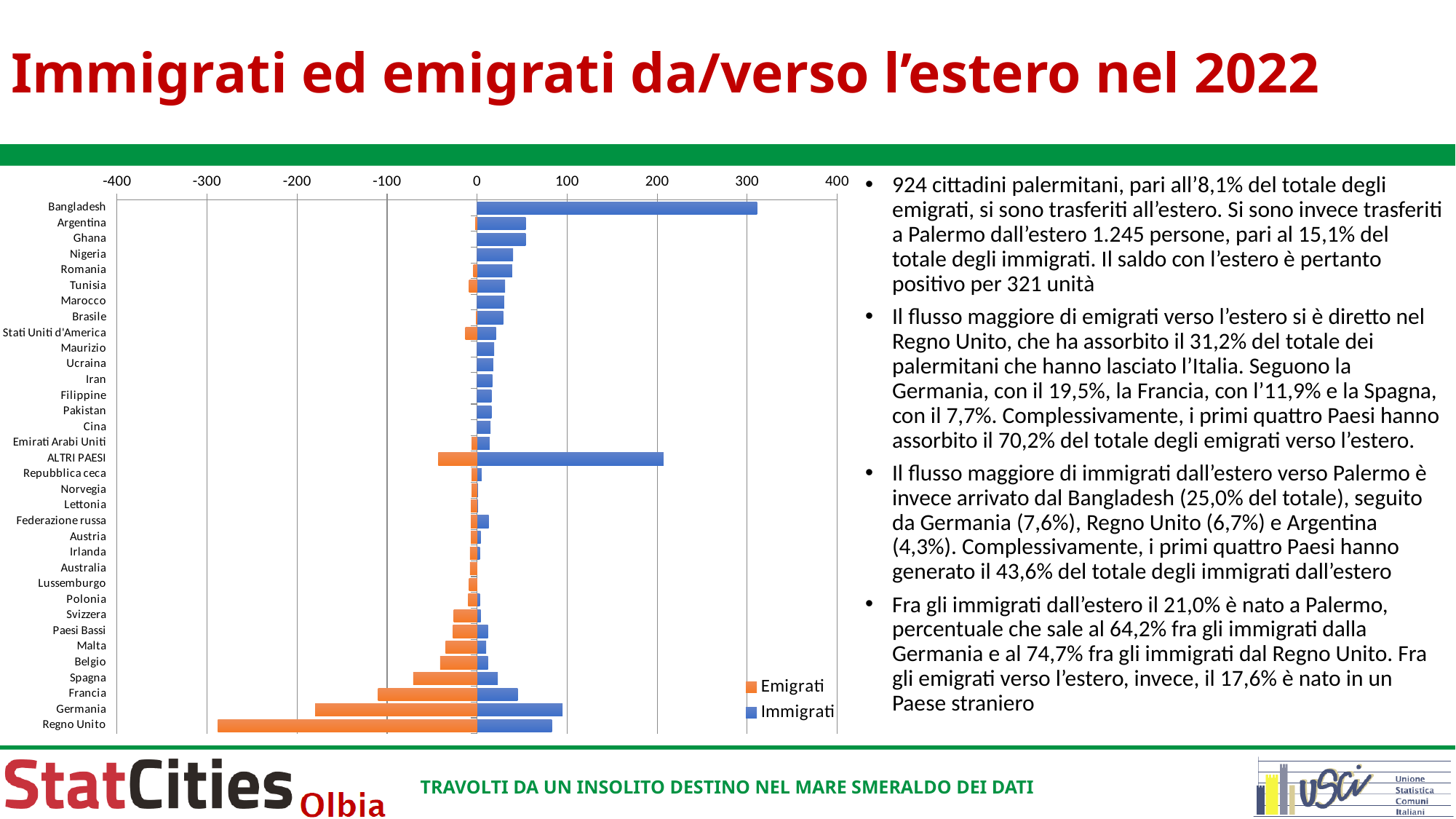
Which category has the largest Emigrati bar (the most negative value)? Regno Unito What are the two series named in the chart legend? Emigrati and Immigrati Is the Emigrati value for Regno Unito greater or less than -200? less Which has the larger Immigrati value, Bangladesh or ALTRI PAESI? Bangladesh Is the Immigrati value for ALTRI PAESI greater or less than 100? greater How many series does the chart legend list? 2 Which has the larger Immigrati value, Germania or Francia? Germania Which category has the highest Immigrati value? Bangladesh Is the Immigrati value for Bangladesh greater or less than 200? greater How many countries/categories are listed on the vertical axis of the chart? 34 What kind of chart is shown on the slide? bar chart Which colour represents the Emigrati series in the chart? orange